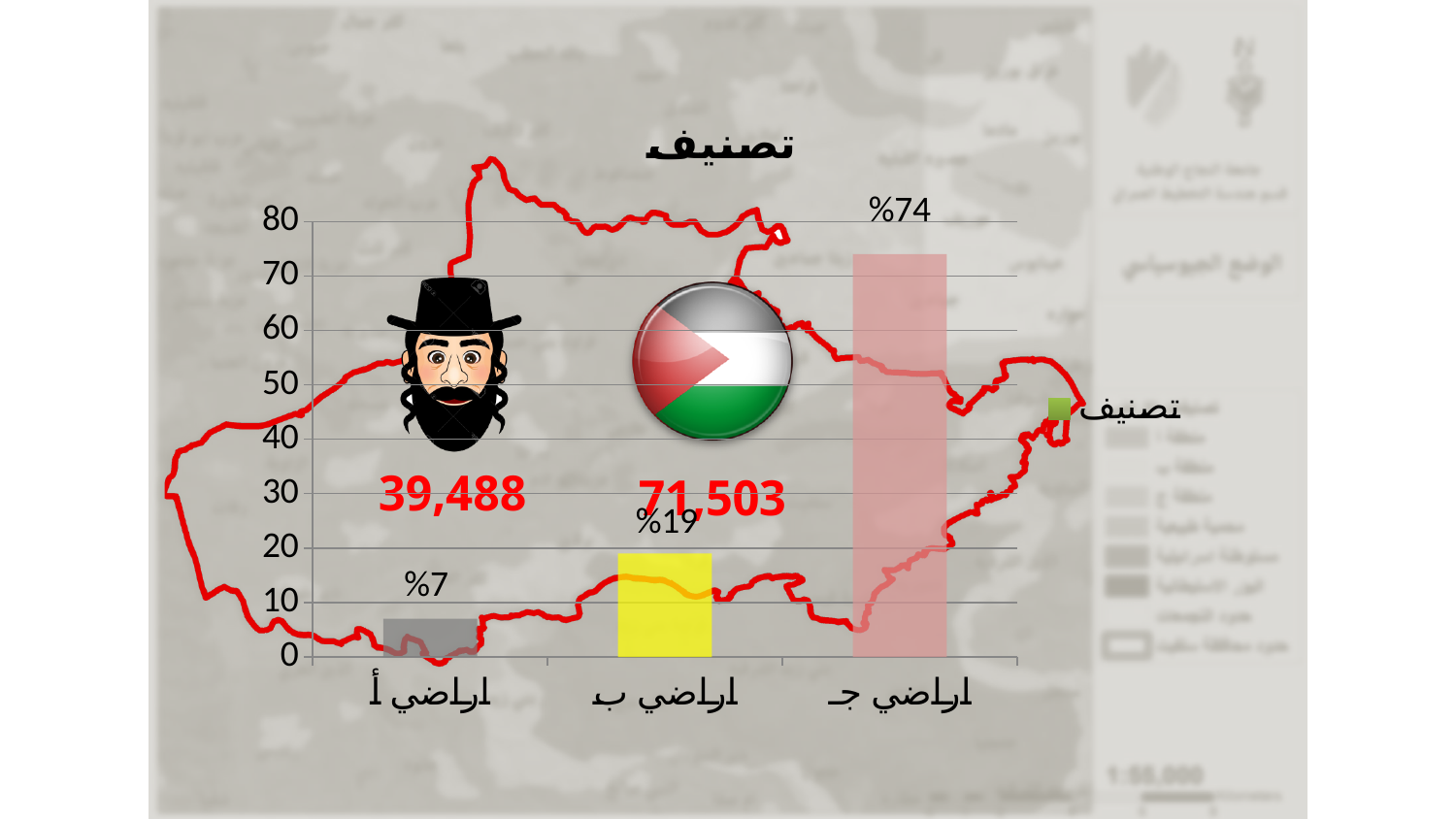
What is the difference between the values for اراضي ب and اراضي أ? %12 Which category has the highest value? اراضي جـ What is the value for اراضي جـ? %74 What is the difference between the values for اراضي جـ and اراضي ب? %55 Which is larger, the value for اراضي ب or the value for اراضي أ? اراضي ب Which category has the lowest value? اراضي أ What is the title of the chart? تصنيف How many categories are shown on the x axis? 3 What kind of chart is shown on the slide? bar chart What is the value for اراضي أ? %7 Is the value for اراضي جـ greater or less than 70? greater What is the value for اراضي ب? %19